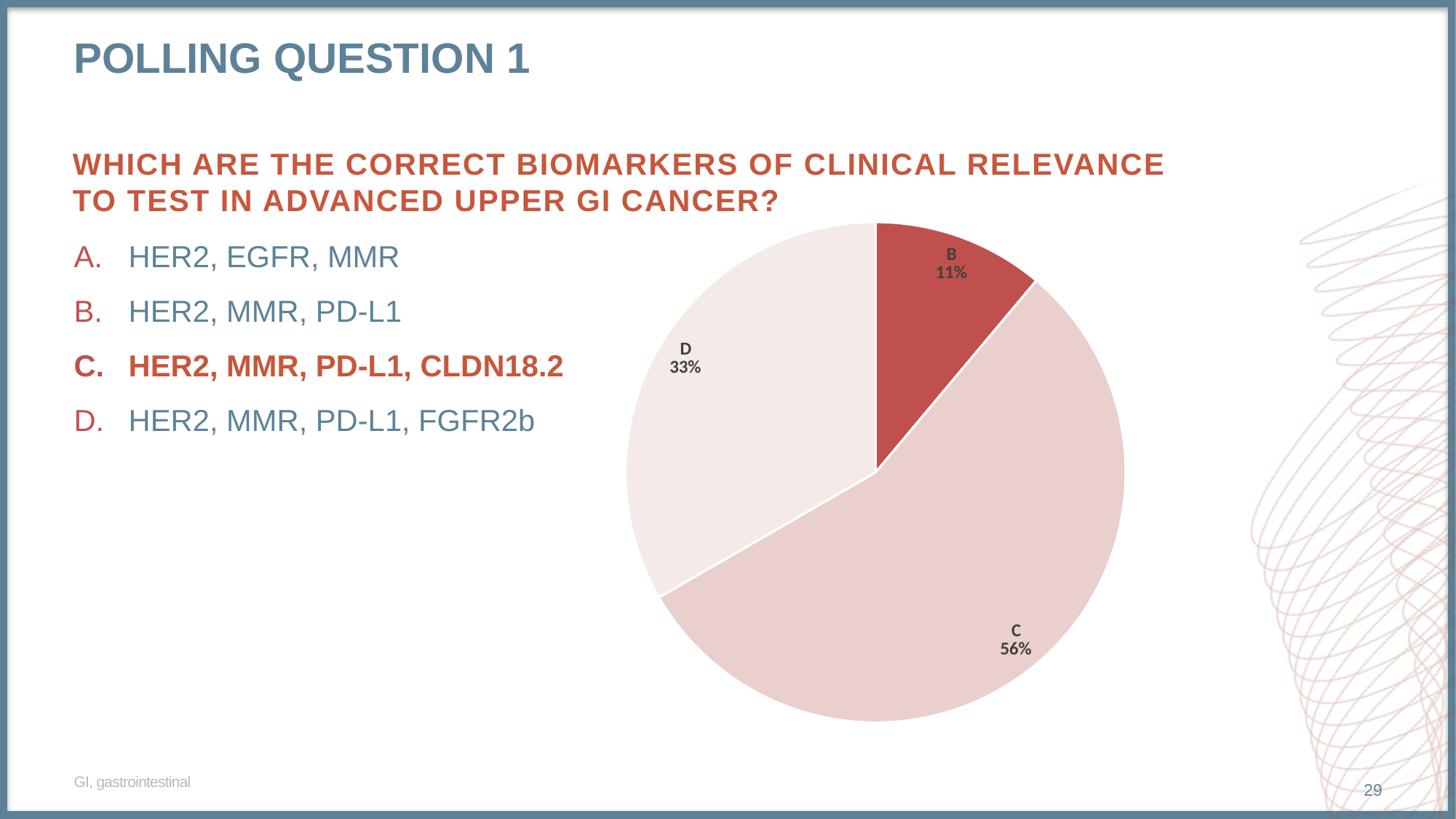
What is the difference in percentage points between the slices for C and D? 23 Which slice is larger, D or B? D What percentage of the pie is labelled for option B? 11% Which slice of the pie is drawn in the darkest red colour? B Which option has the largest slice of the pie? C What share of the pie does option C account for? 56% What kind of chart is shown on the slide? pie chart What is the difference in percentage points between the slices for D and B? 22 How many labelled slices does the pie chart have? 3 What percentage of the pie is labelled for option D? 33% Which option has the smallest slice of the pie? B What percentage of the pie is labelled for option C? 56%